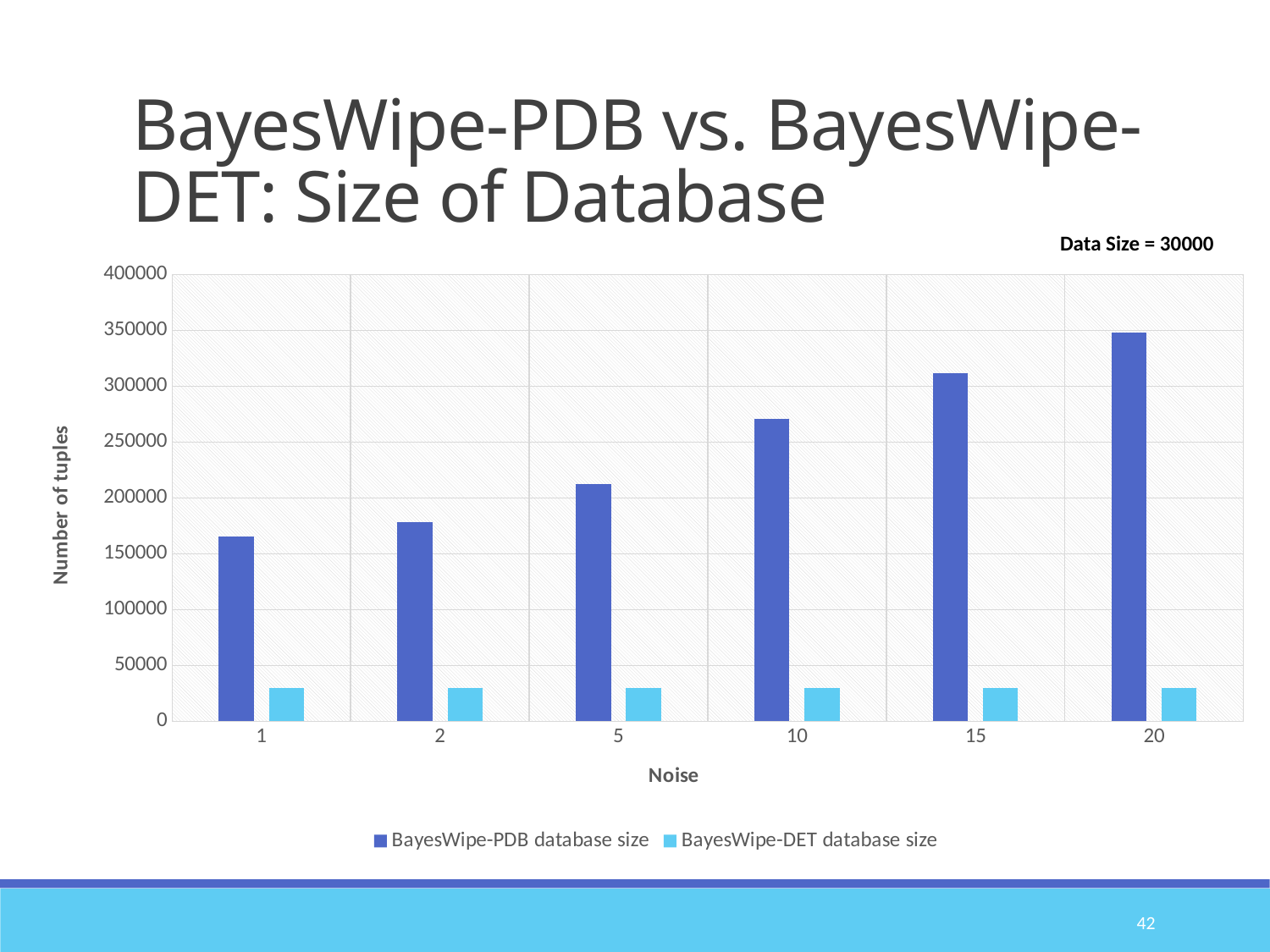
At which noise level is the BayesWipe-PDB database size highest? 20 How many series does the legend list? 2 What is the label of the y axis? Number of tuples Is the BayesWipe-DET database size at noise 10 greater or less than 50000? less What kind of chart is shown on the slide? bar chart Is the BayesWipe-PDB database size at noise 1 greater or less than 200000? less At which noise level is the BayesWipe-PDB database size lowest? 1 How many noise levels are shown on the x axis? 6 Does the BayesWipe-PDB database size rise or fall as noise increases along the x axis? rise At noise 5, which is larger: the BayesWipe-PDB database size or the BayesWipe-DET database size? BayesWipe-PDB database size Is the BayesWipe-PDB database size at noise 20 greater or less than 300000? greater